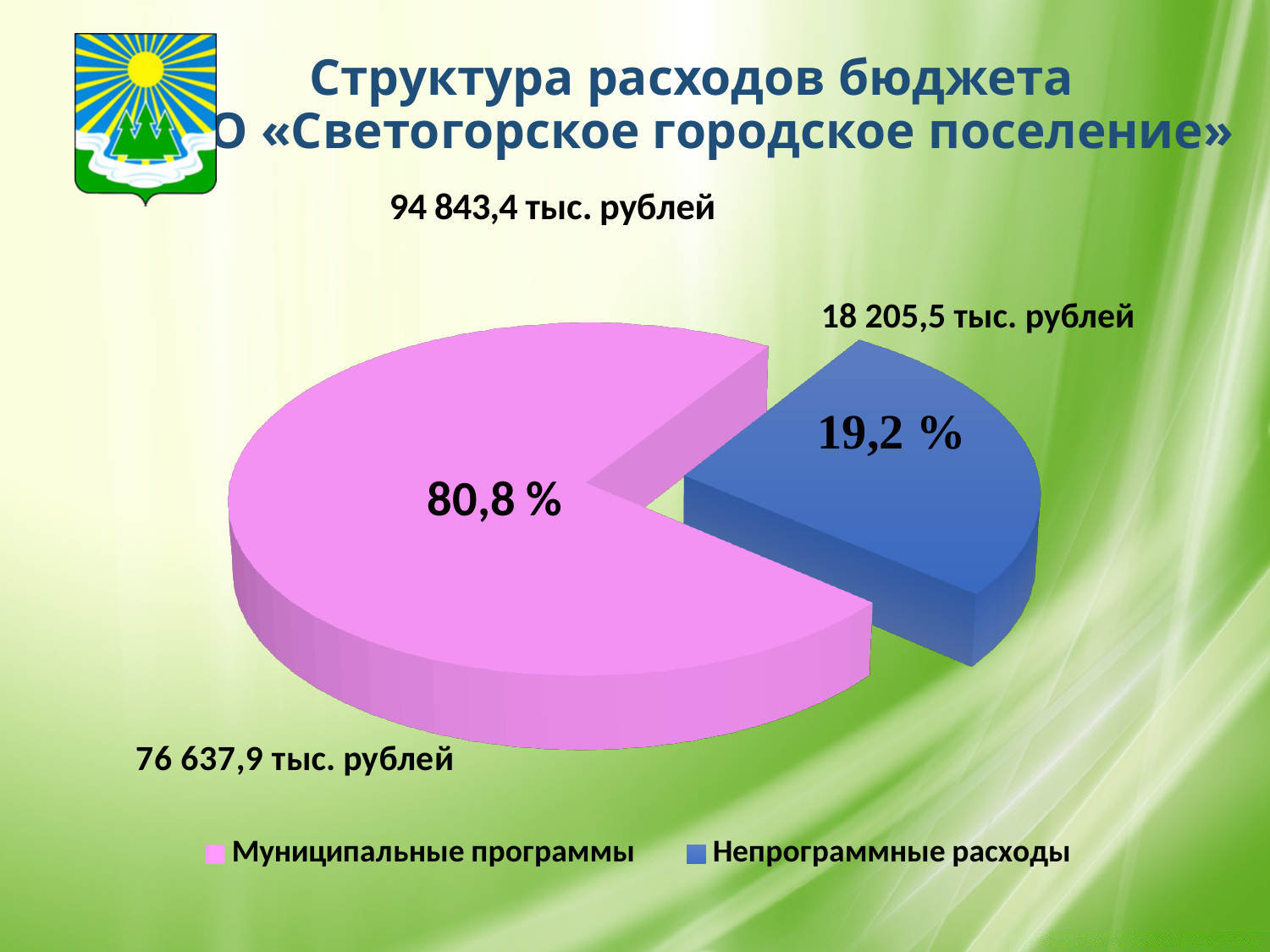
How many series does the legend list? 2 What kind of chart is shown on the slide? pie chart What is the value labelled for «Муниципальные программы»? 76 637,9 тыс. рублей How many slices does the pie chart have? 2 What is the difference in percentage points between the «Муниципальные программы» and «Непрограммные расходы» shares? 61,6 % What share of the pie does «Непрограммные расходы» take? 19,2 % Which slice is the smallest? Непрограммные расходы What share of the pie does «Муниципальные программы» take? 80,8 % Which is larger, «Муниципальные программы» or «Непрограммные расходы»? Муниципальные программы What colour is the «Непрограммные расходы» slice? blue What is the value labelled for «Непрограммные расходы»? 18 205,5 тыс. рублей Which slice is the largest? Муниципальные программы